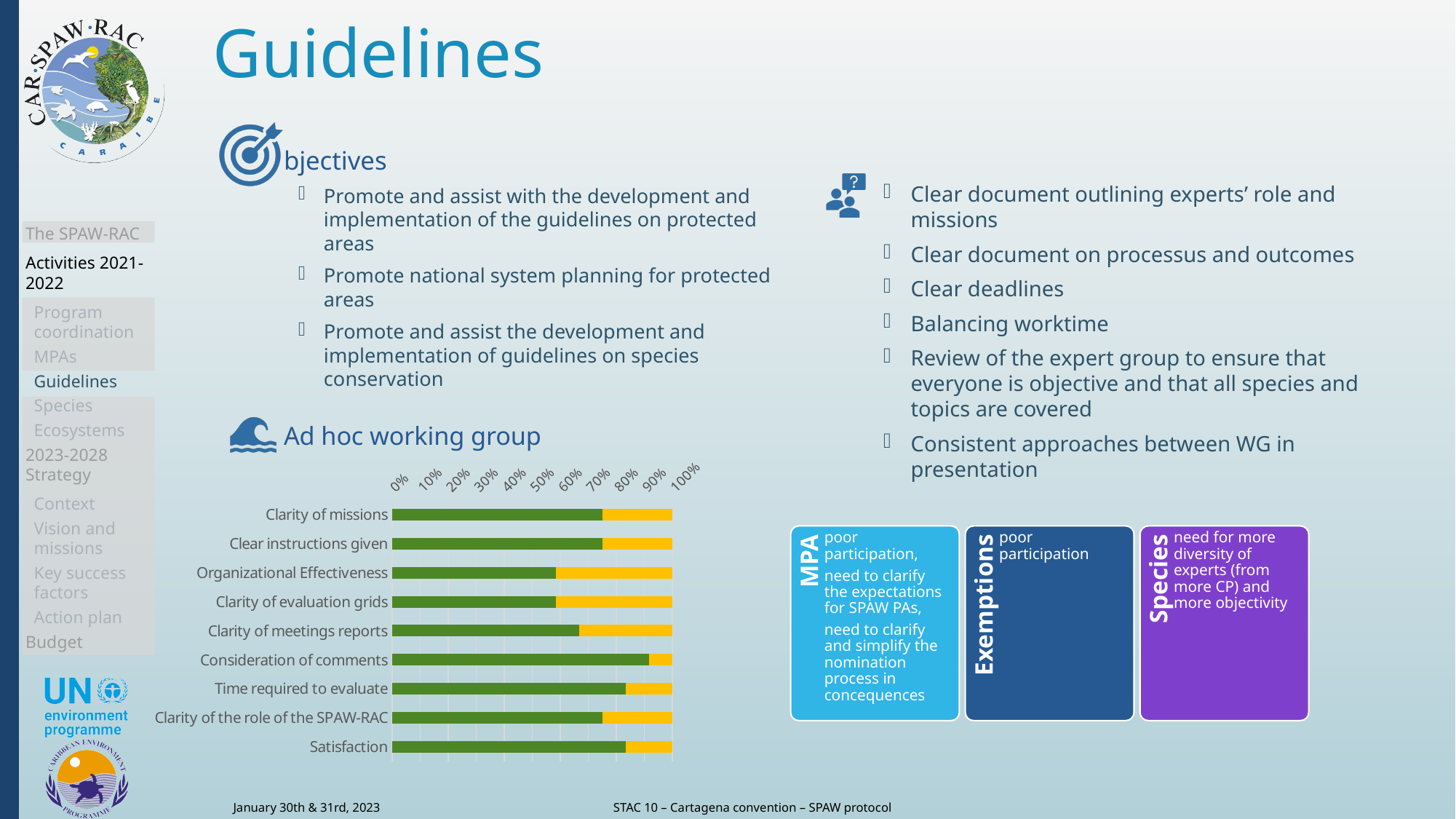
In the 'Ad hoc working group' chart, is the green segment for 'Time required to evaluate' greater or less than 80%? greater In the 'Ad hoc working group' chart, is the green segment for 'Consideration of comments' greater or less than 80%? greater In the 'Ad hoc working group' chart, is the green segment for 'Organizational Effectiveness' greater or less than 70%? less In the 'Ad hoc working group' chart, what value on the axis does each stacked bar reach in total? 100% In the 'Ad hoc working group' chart, which has the larger green segment: 'Consideration of comments' or 'Organizational Effectiveness'? Consideration of comments What kind of chart is shown under 'Ad hoc working group'? bar chart What two colours are used for the segments in the 'Ad hoc working group' chart? green and yellow In the 'Ad hoc working group' chart, which category has the longest green segment? Consideration of comments How many categories are plotted in the 'Ad hoc working group' chart? 9 In the 'Ad hoc working group' chart, which has the larger green segment: 'Time required to evaluate' or 'Clarity of evaluation grids'? Time required to evaluate